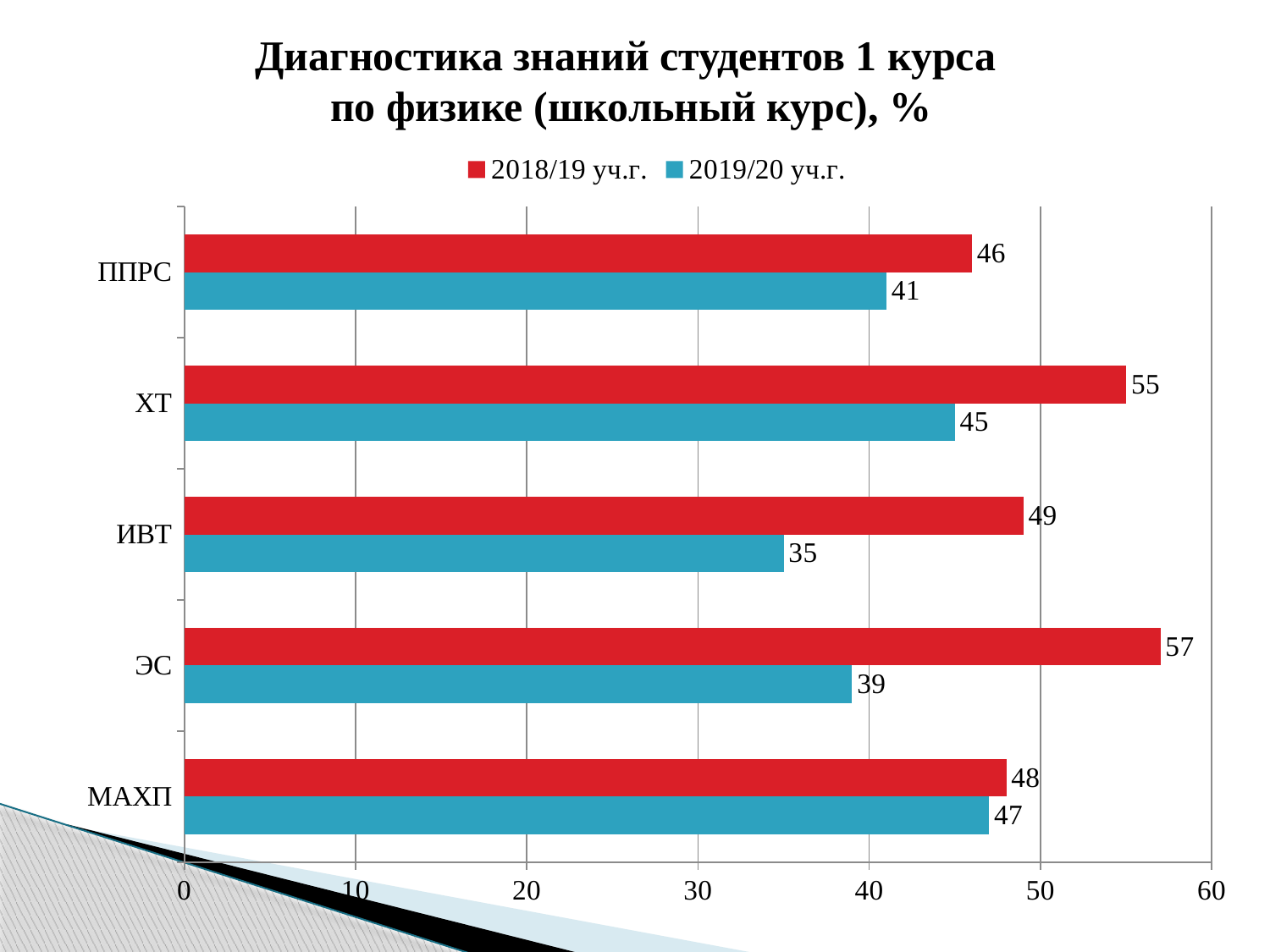
Which category has the lowest value in the 2019/20 уч.г. series? ИВТ Which colour represents the 2019/20 уч.г. series? blue What is the title of the chart? Диагностика знаний студентов 1 курса по физике (школьный курс), % What is the difference between the 2018/19 уч.г. and 2019/20 уч.г. values for ЭС? 18 How many series does the legend list? 2 Which is larger for ППРС: the 2018/19 уч.г. value or the 2019/20 уч.г. value? 2018/19 уч.г. Which category has the highest value in the 2018/19 уч.г. series? ЭС What is the value for ХТ in the 2018/19 уч.г. series? 55 What is the value for МАХП in the 2019/20 уч.г. series? 47 What is the value for ИВТ in the 2019/20 уч.г. series? 35 How many categories are shown on the chart? 5 What kind of chart is shown on the slide? bar chart